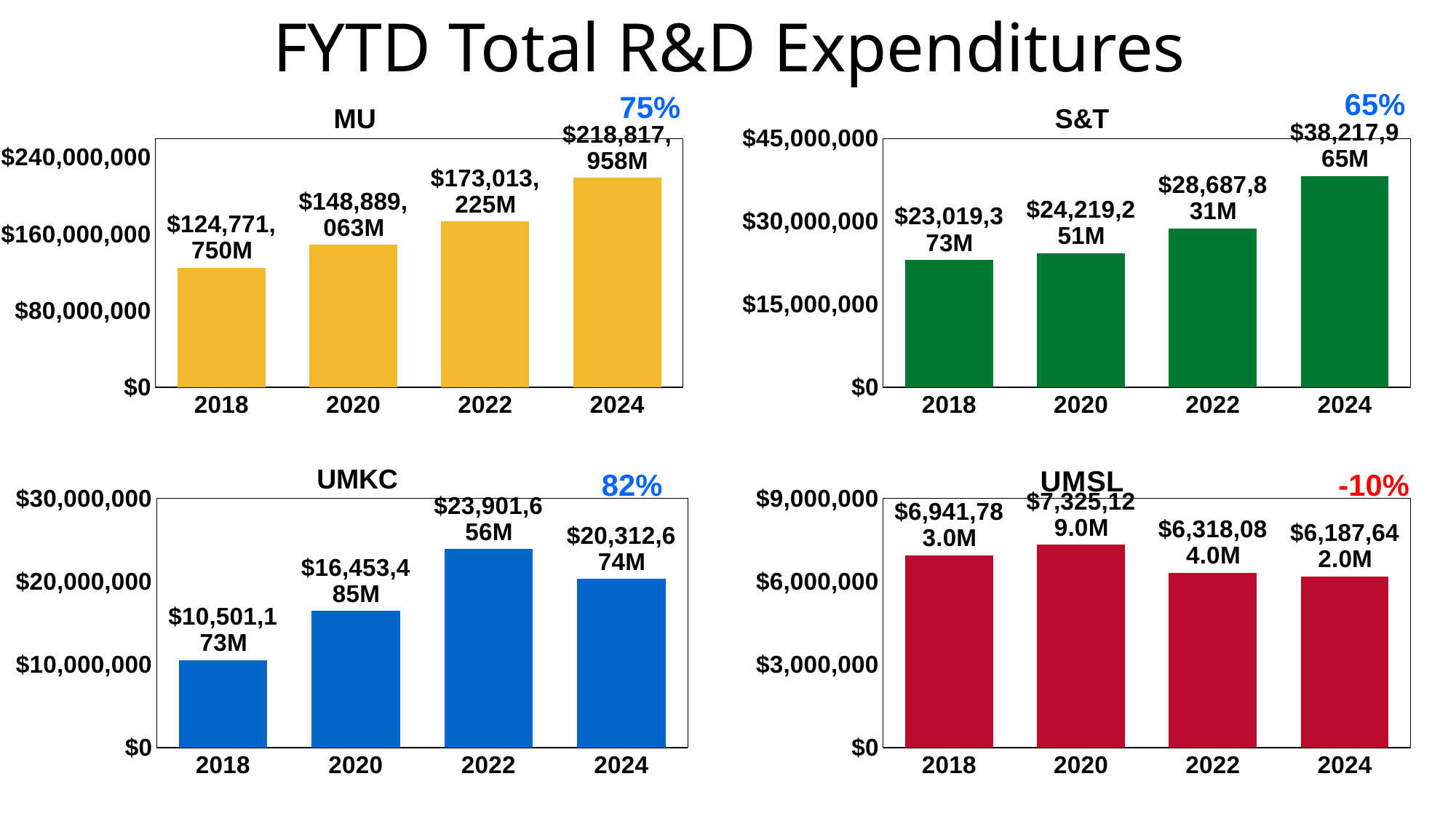
In the UMSL chart, which is larger, the value for 2020 or the value for 2018? 2020 In the UMKC chart, which year has the highest value? 2022 In the UMSL chart, which year has the lowest value? 2024 How many years are shown in the MU chart? 4 What percentage change is shown above the UMSL chart? -10% In the UMKC chart, what is the value for 2020? $16,453,485M What kind of chart is the S&T chart? bar chart In the MU chart, what is the value for 2024? $218,817,958M In the S&T chart, what is the value for 2018? $23,019,373M In the UMSL chart, what is the value for 2022? $6,318,084.0M In the S&T chart, is the value for 2024 greater or less than $30,000,000? greater In the MU chart, which year has the lowest value? 2018